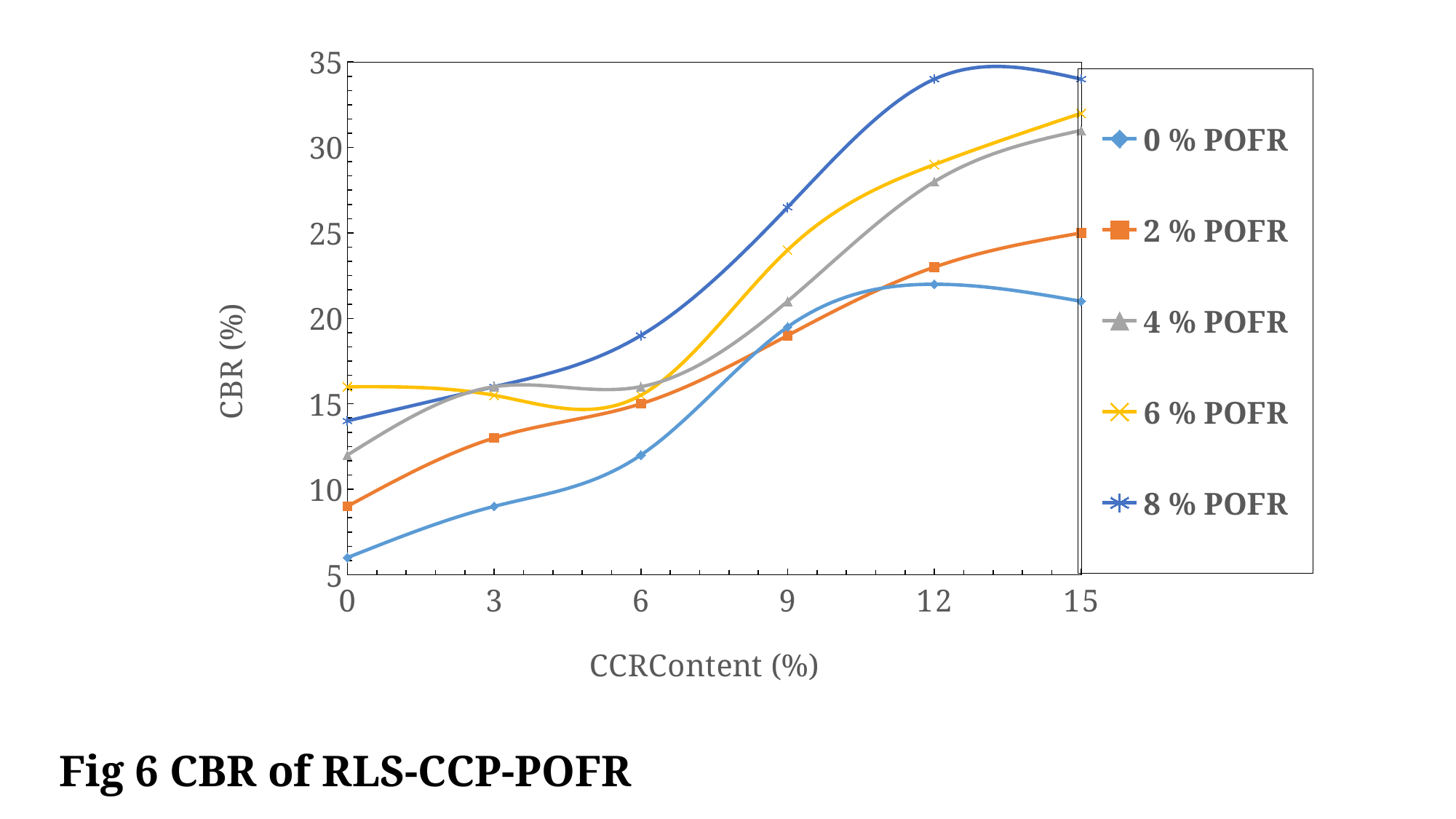
What is the CBR value for 2 % POFR at 15% CCR content? 25 How many CCR content values are plotted along the x axis for each series? 6 Does the CBR for 8 % POFR rise or fall as CCR content increases from 0% to 12%? rise Is the CBR value for 8 % POFR at 12% CCR content greater or less than 30? greater At 9% CCR content, which series has the larger CBR: 8 % POFR or 0 % POFR? 8 % POFR How many series does the legend list? 5 Which series has the highest CBR at 15% CCR content? 8 % POFR What is the title of the x axis? CCRContent (%) Is the CBR value for 6 % POFR at 15% CCR content greater or less than 30? greater What kind of chart is shown on the slide? line chart Is the CBR value for 0 % POFR at 0% CCR content greater or less than 10? less Which series has the lowest CBR at 0% CCR content? 0 % POFR